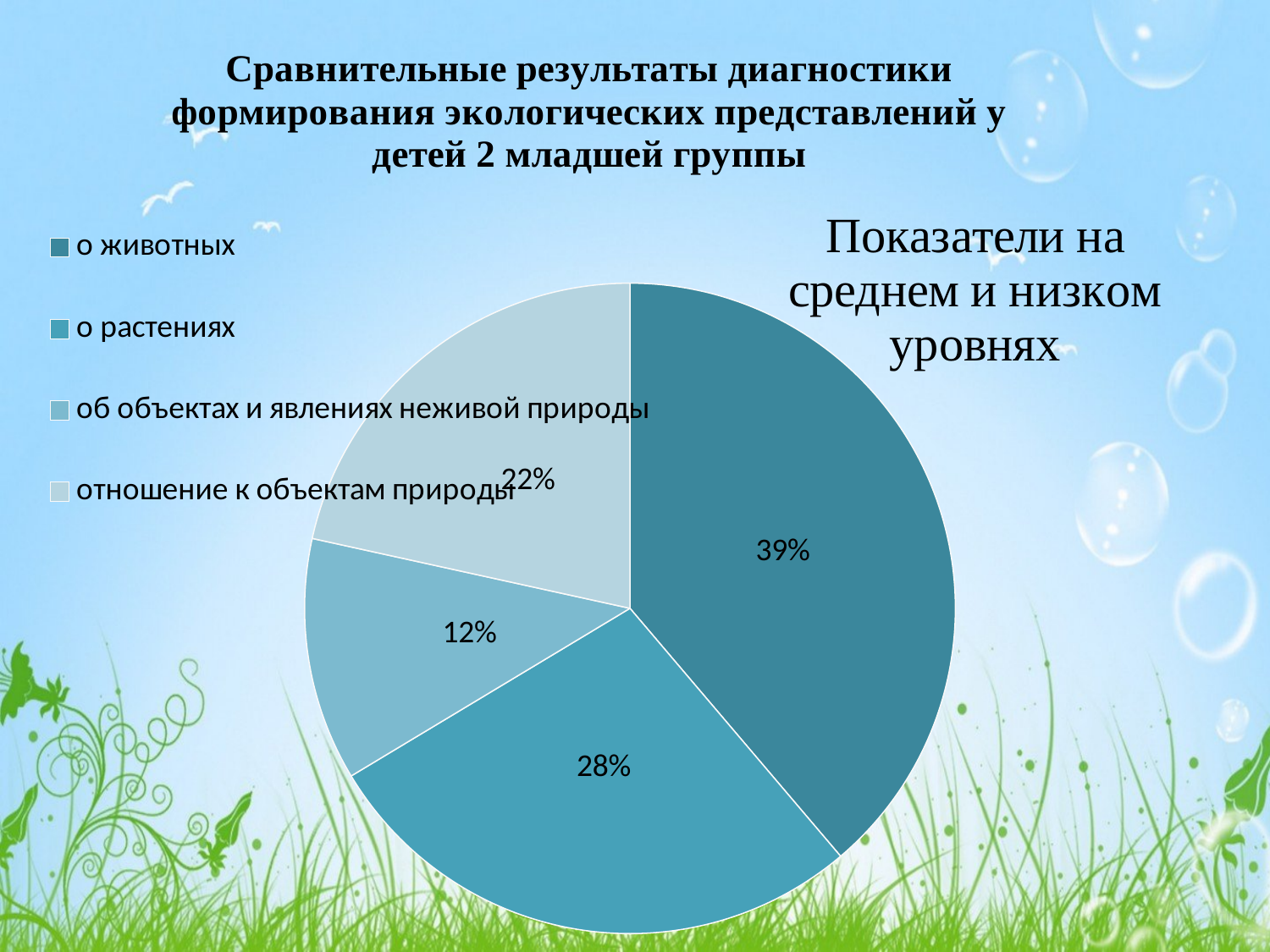
How many entries does the legend list? 4 How many slices does the pie chart have? 4 What is the difference in percentage points between the slices for "о животных" and "о растениях"? 11 Which category has the smallest slice of the pie? об объектах и явлениях неживой природы What share of the pie does the slice for "об объектах и явлениях неживой природы" represent? 12% What share of the pie does the slice for "о растениях" represent? 28% What is the title shown next to the pie chart? Показатели на среднем и низком уровнях Which category has the largest slice of the pie? о животных What share of the pie does the slice for "о животных" represent? 39% What type of chart is shown on the slide? pie chart What share of the pie does the slice for "отношение к объектам природы" represent? 22% Which slice is larger: "отношение к объектам природы" or "об объектах и явлениях неживой природы"? отношение к объектам природы